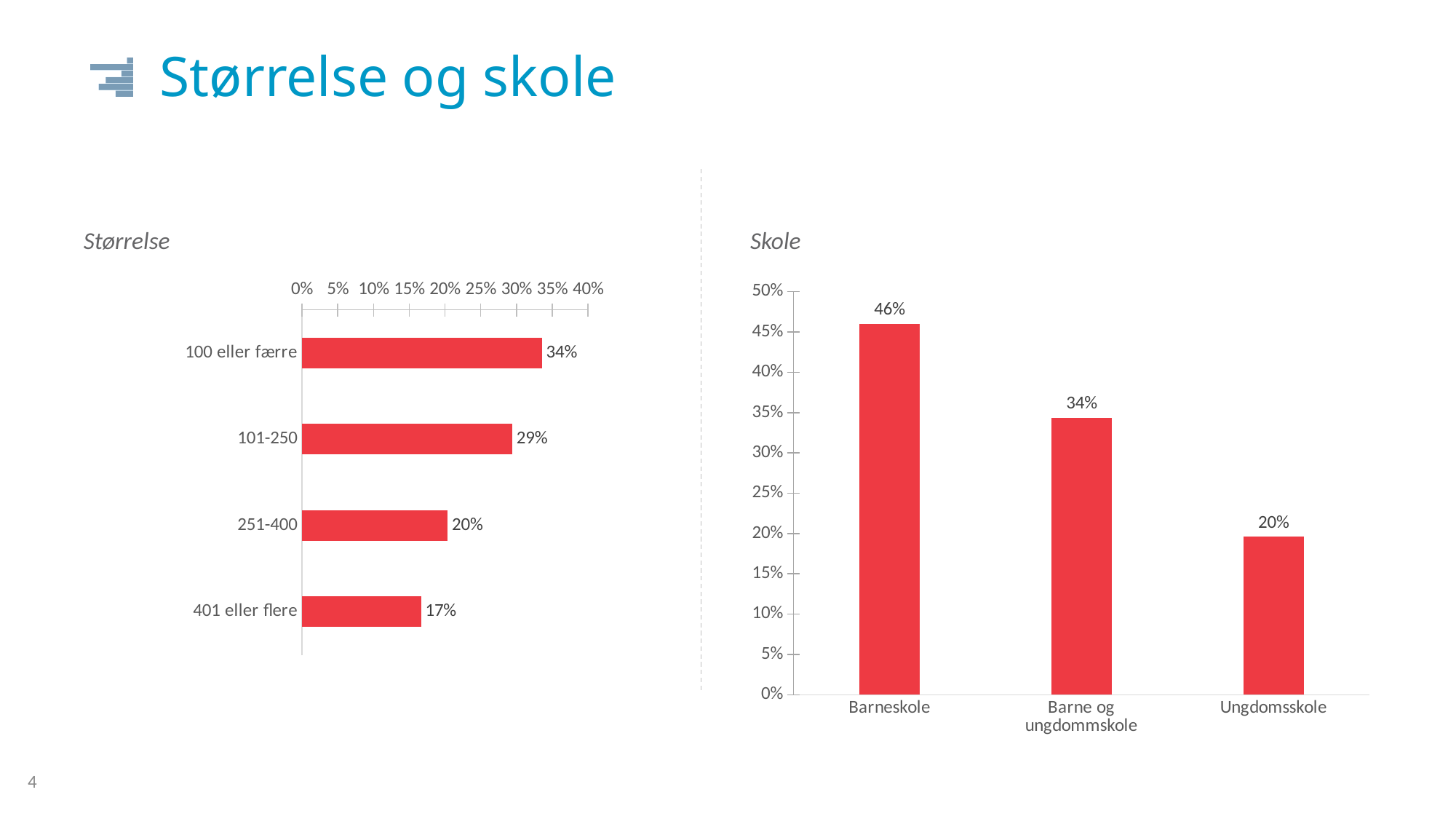
In the Størrelse chart, what is the difference between the values for 100 eller færre and 101-250? 5% What kind of chart is the Skole chart? bar chart In the Skole chart, which category has the highest value? Barneskole In the Skole chart, which is larger, the value for Barne og ungdommskole or the value for Ungdomsskole? Barne og ungdommskole In the Skole chart, what is the value for Barneskole? 46% In the Skole chart, what is the value for Ungdomsskole? 20% In the Størrelse chart, which category has the lowest value? 401 eller flere In the Skole chart, what is the difference between the values for Barneskole and Barne og ungdommskole? 12% In the Størrelse chart, do the values rise or fall from the top category to the bottom category? fall In the Størrelse chart, what is the value for 251-400? 20% In the Størrelse chart, how many categories are shown? 4 In the Størrelse chart, what is the value for 100 eller færre? 34%